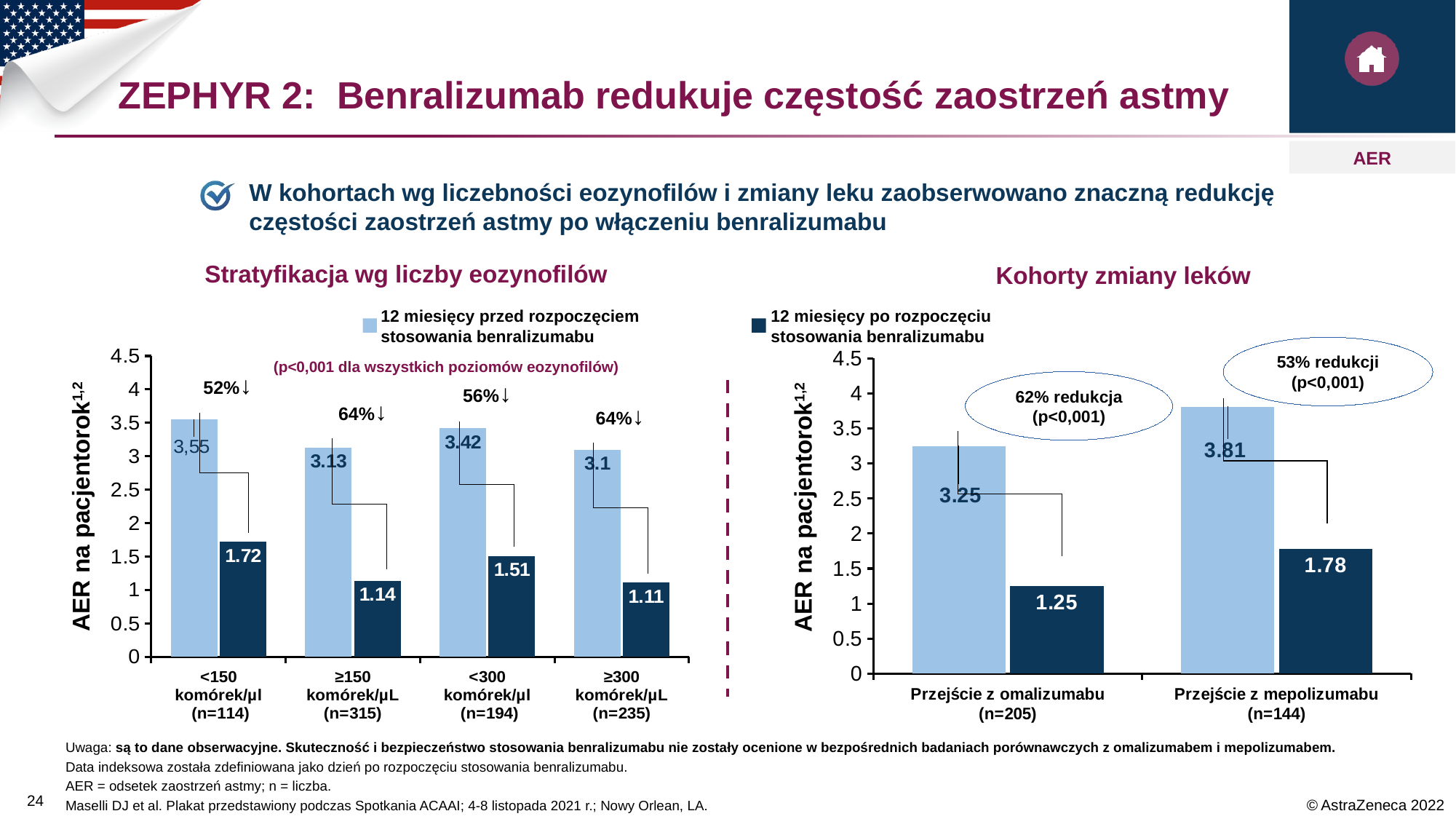
In the chart 'Stratyfikacja wg liczby eozynofilów', what is the AER for the '<150 komórek/µl (n=114)' group 12 months after starting benralizumab? 1.72 What type of chart is 'Kohorty zmiany leków'? Bar chart In the chart 'Stratyfikacja wg liczby eozynofilów', what is the difference between the before and after AER values for the '<300 komórek/µl (n=194)' group? 1.91 In the chart 'Kohorty zmiany leków', what is the AER for 'Przejście z omalizumabu (n=205)' 12 months after starting benralizumab? 1.25 In the chart 'Kohorty zmiany leków', what is the difference between the before and after AER values for 'Przejście z omalizumabu (n=205)'? 2.00 In the chart 'Kohorty zmiany leków', which cohort has the higher AER 12 months after starting benralizumab: 'Przejście z omalizumabu' or 'Przejście z mepolizumabu'? Przejście z mepolizumabu In the chart 'Kohorty zmiany leków', what percentage reduction is annotated for the 'Przejście z mepolizumabu' cohort? 53% redukcji In the chart 'Stratyfikacja wg liczby eozynofilów', what is the AER for the '≥150 komórek/µL (n=315)' group 12 months before starting benralizumab? 3.13 In the chart 'Stratyfikacja wg liczby eozynofilów', how many eosinophil categories are shown on the x axis? 4 In the chart 'Stratyfikacja wg liczby eozynofilów', which eosinophil group has the lowest AER 12 months after starting benralizumab? ≥300 komórek/µL (n=235) In the chart 'Stratyfikacja wg liczby eozynofilów', what is the AER for the '≥300 komórek/µL (n=235)' group 12 months after starting benralizumab? 1.11 In the chart 'Kohorty zmiany leków', what is the AER for 'Przejście z mepolizumabu (n=144)' 12 months before starting benralizumab? 3.81